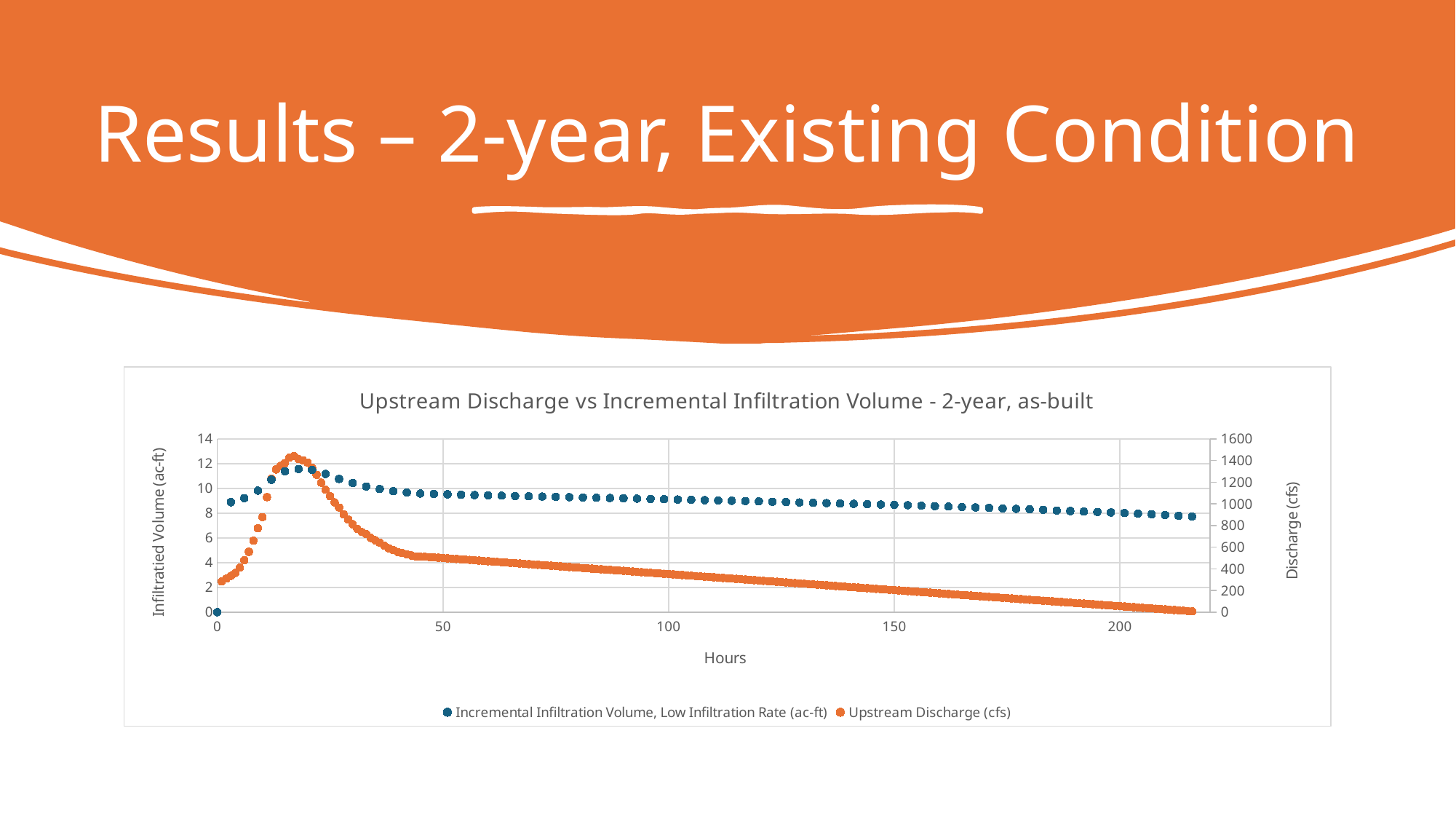
What is the Incremental Infiltration Volume value at hour 0? 0 Is the Incremental Infiltration Volume value at hour 200 greater or less than 10? less Is the peak value of the Upstream Discharge (cfs) series greater or less than 1200? greater What kind of chart is shown on the slide? scatter chart Does the Upstream Discharge (cfs) series rise or fall between hour 50 and hour 200? fall Is the Incremental Infiltration Volume value at hour 50 greater or less than 8? greater What is the label of the x axis of the chart? Hours What is the title of the chart? Upstream Discharge vs Incremental Infiltration Volume - 2-year, as-built Does the Incremental Infiltration Volume series rise or fall between hour 50 and hour 200? fall How many series does the chart legend list? 2